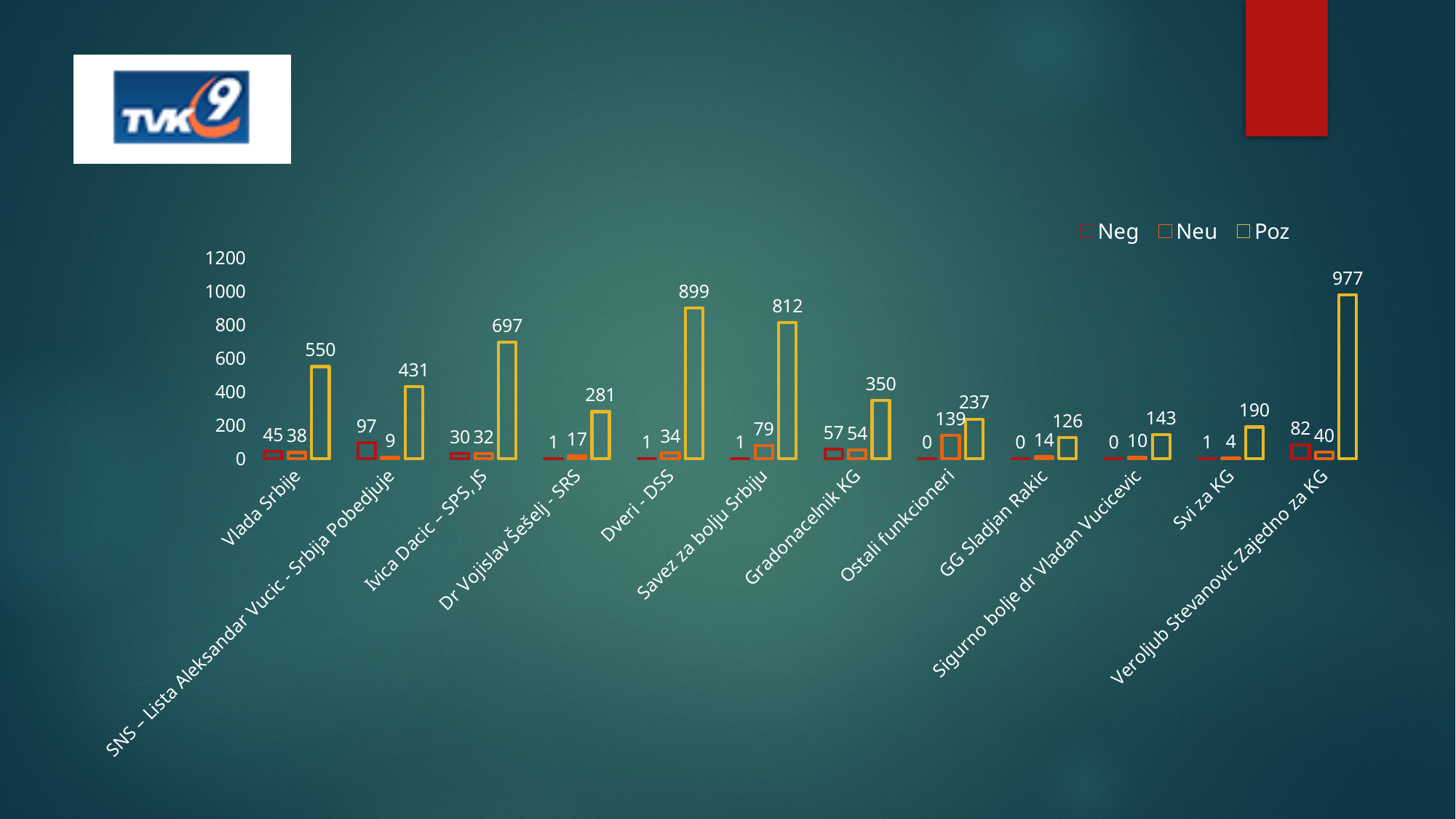
Which is larger, the Poz value for Ivica Dacic – SPS, JS or the Poz value for Vlada Srbije? Ivica Dacic – SPS, JS What is the difference between the Poz values for Dveri - DSS and Savez za bolju Srbiju? 87 What is the Poz value for Dveri - DSS? 899 What kind of chart is shown on the slide? bar chart Which category has the lowest Poz value? GG Sladjan Rakic What is the Neu value for Ostali funkcioneri? 139 Which category has the highest Poz value? Veroljub Stevanovic Zajedno za KG How many categories are shown on the x axis? 12 How many series does the legend list? 3 What is the Neg value for SNS – Lista Aleksandar Vucic - Srbija Pobedjuje? 97 What is the total of the Neg, Neu and Poz values for Vlada Srbije? 633 Is the Poz value for Gradonacelnik KG greater or less than 400? less